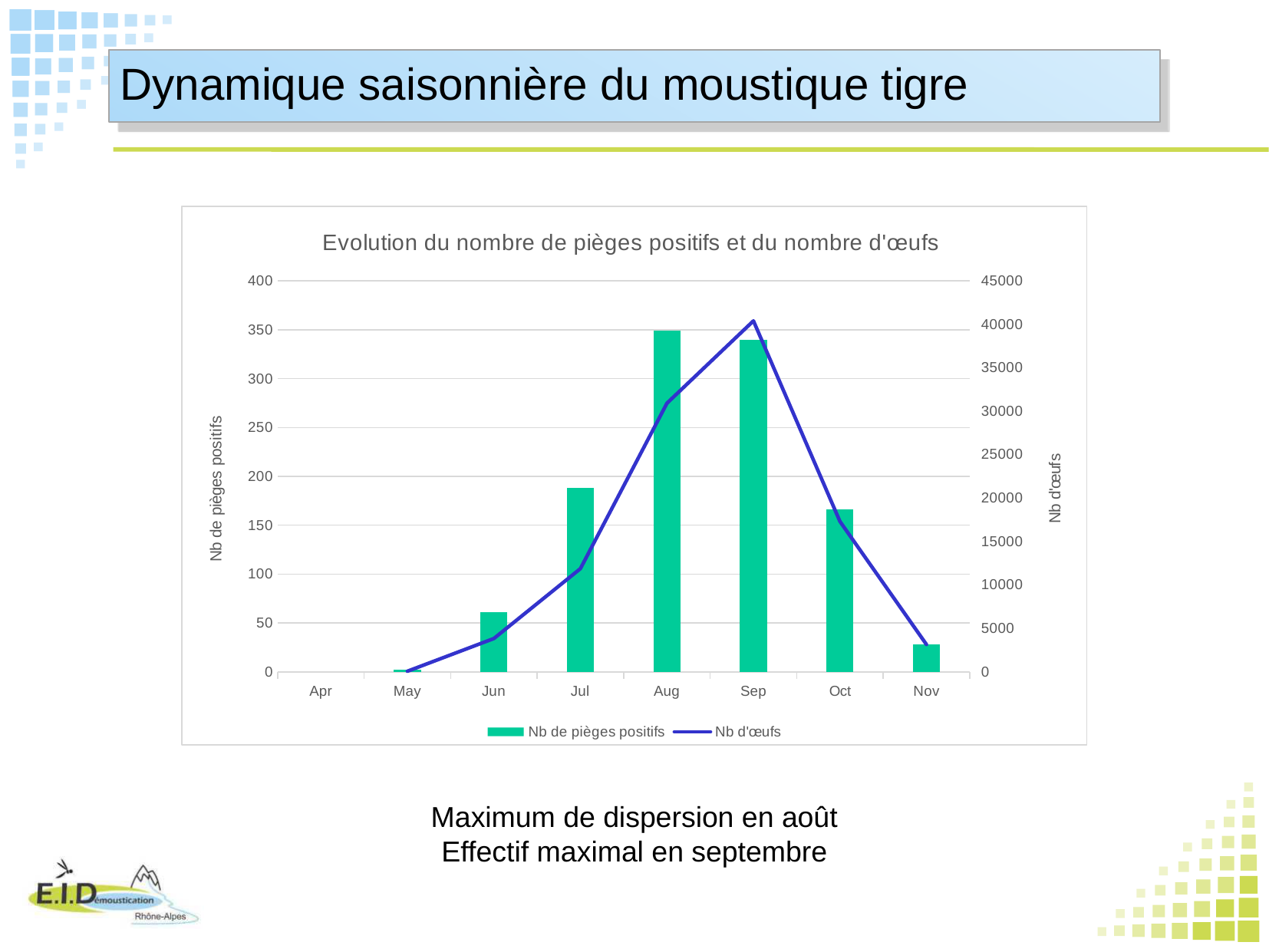
How does the 'Nb d'œufs' line change from Sep to Nov? It falls Is the 'Nb de pièges positifs' value for Jun greater or less than 100? less Is the 'Nb d'œufs' value for Jul greater or less than 10000? greater How many series does the chart legend list? 2 What kind of chart is shown on the slide? Combined bar and line chart Is the 'Nb de pièges positifs' value for Nov greater or less than 50? less Which month has the highest number of 'Nb d'œufs' (the line series)? Sep Which month has the highest bar for 'Nb de pièges positifs'? Aug What is the title of the chart? Evolution du nombre de pièges positifs et du nombre d'œufs How many months are shown on the x axis of the chart? 8 Which month has the larger 'Nb de pièges positifs' bar, Jul or Oct? Jul